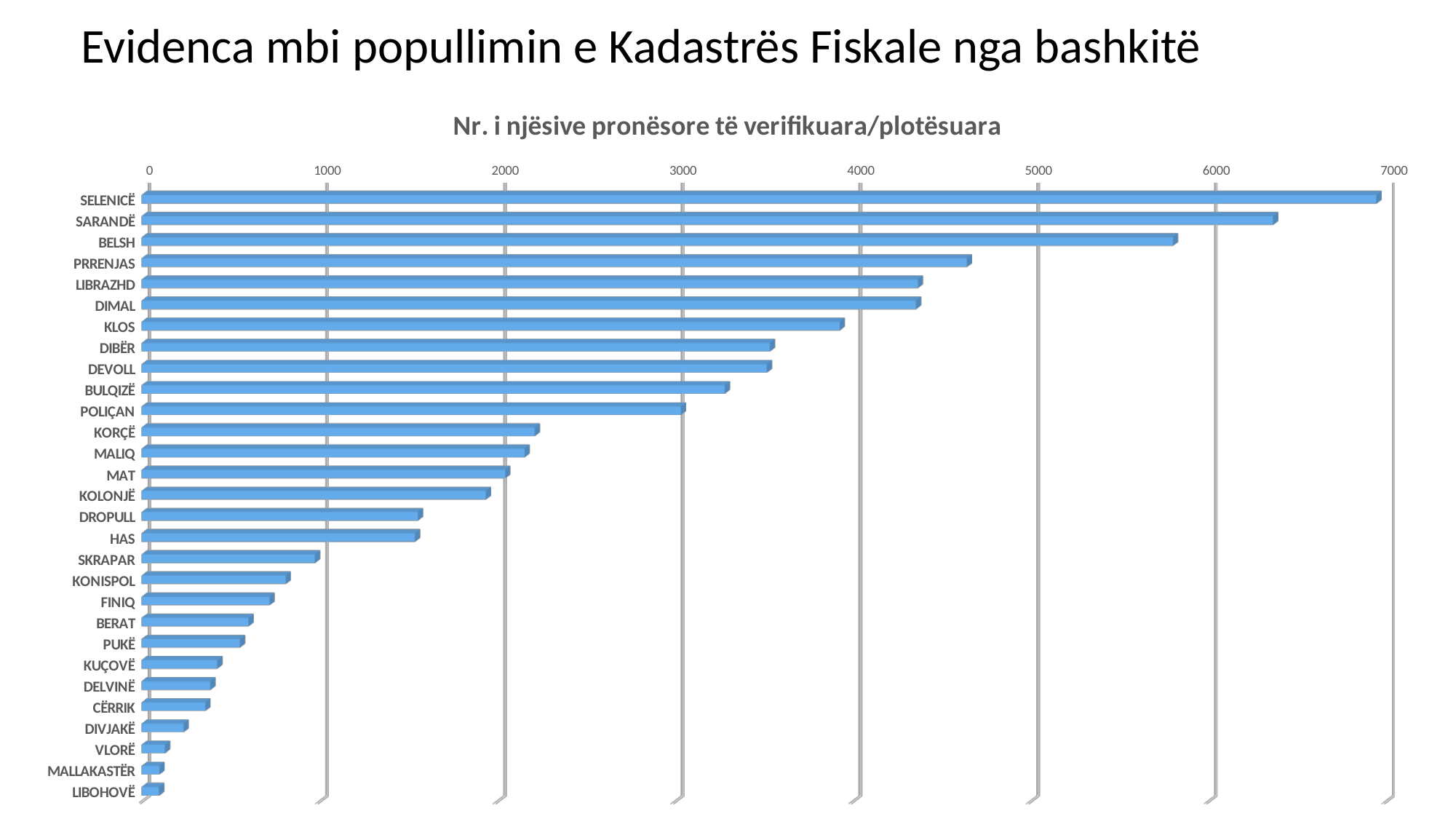
What is the title of the chart? Nr. i njësive pronësore të verifikuara/plotësuara Which has a larger value, HAS or SKRAPAR? HAS How many municipalities (categories) are plotted in the chart? 29 Which has a larger value, SARANDË or BELSH? SARANDË What kind of chart is shown on the slide? bar chart Is the value for SELENICË greater or less than 6000? greater Is the value for BELSH greater or less than 5000? greater What is the highest value shown on the horizontal axis? 7000 Is the value for KLOS greater or less than 4000? less Which municipality has the highest value in the chart? SELENICË